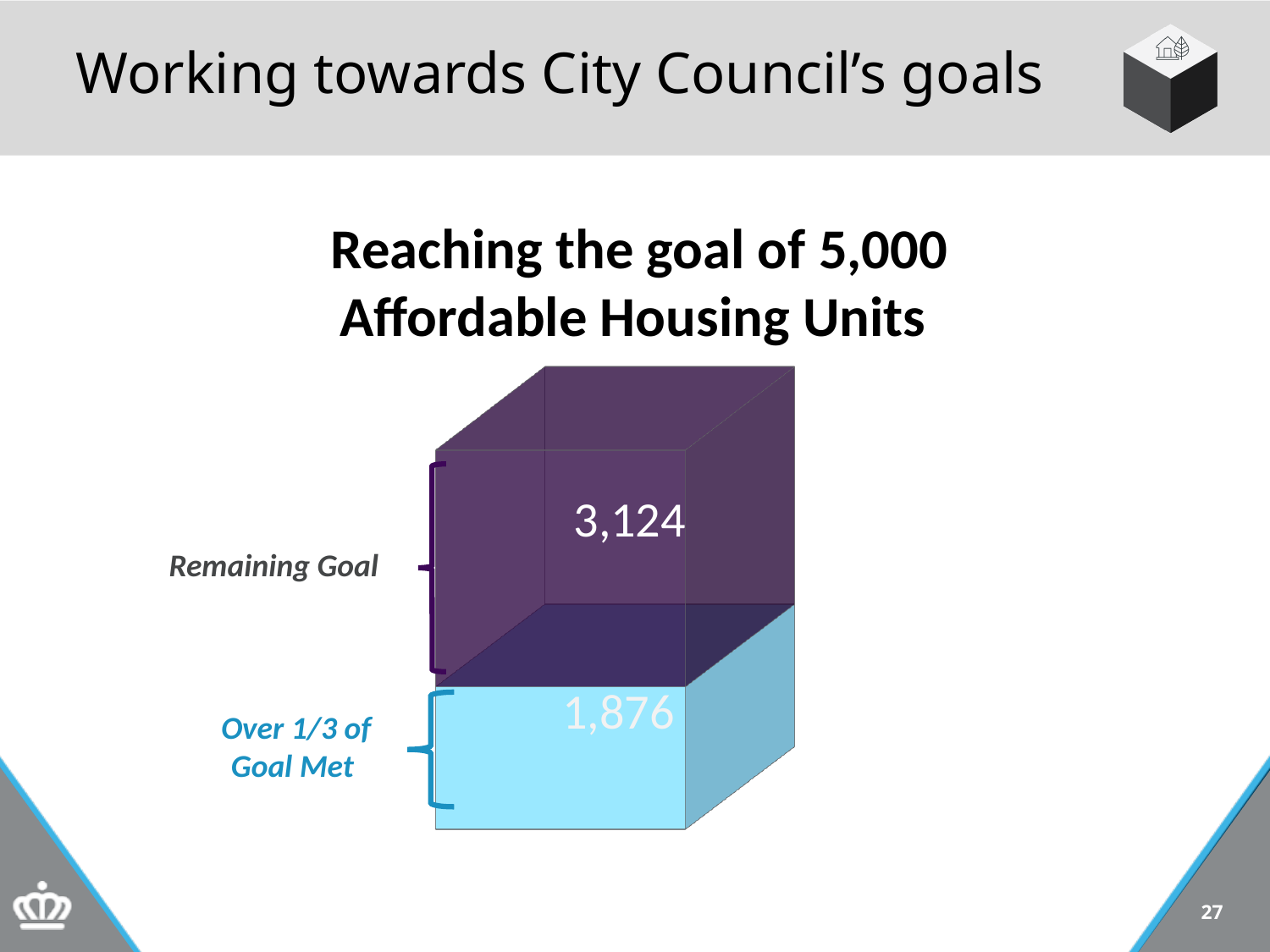
Which segment is larger, Remaining Goal or Goal Met? Remaining Goal What kind of chart is shown on the slide? Stacked bar chart Which segment has the smallest value? Goal Met What is the total of the two stacked segments? 5,000 What is the title of the chart? Reaching the goal of 5,000 Affordable Housing Units What is the difference between the Remaining Goal value and the Goal Met value? 1,248 What value is shown for the Remaining Goal segment? 3,124 What value is shown for the Goal Met segment? 1,876 How many segments make up the stacked bar? 2 What colour is the Goal Met segment? Light blue